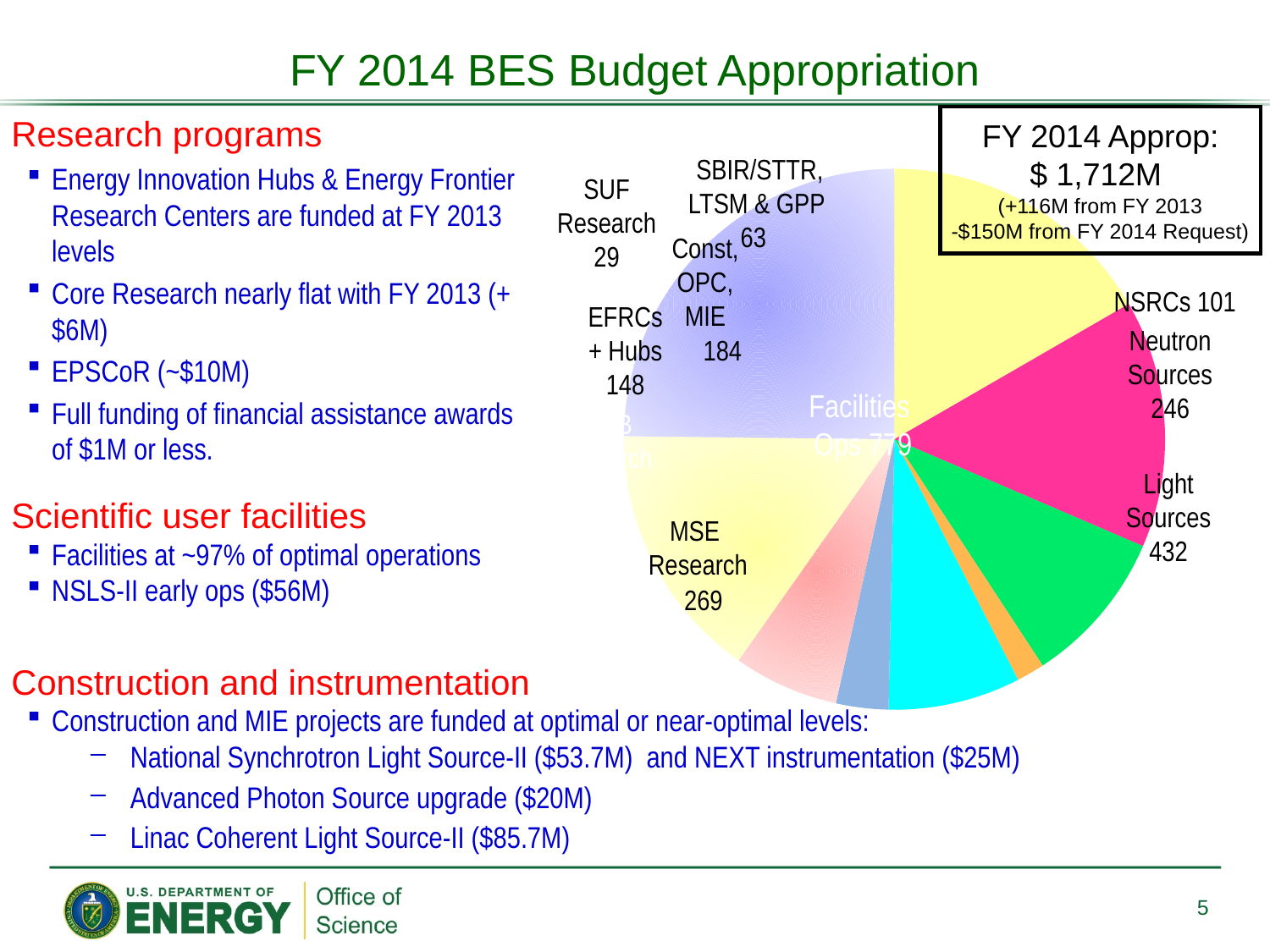
What is the value for Light Sources in the pie chart? 432 What kind of chart is shown on the slide? pie chart What is the value for NSRCs in the pie chart? 101 What is the value for MSE Research in the pie chart? 269 What is the difference between the Light Sources value and the Neutron Sources value? 186 What is the value for Neutron Sources in the pie chart? 246 Which is larger, the value for MSE Research or the value for Const, OPC, MIE? MSE Research What total FY 2014 appropriation is stated in the box next to the pie chart? $ 1,712M Which labelled category has the smallest value in the pie chart? SUF Research What is the value for EFRCs + Hubs in the pie chart? 148 What is the value for SUF Research in the pie chart? 29